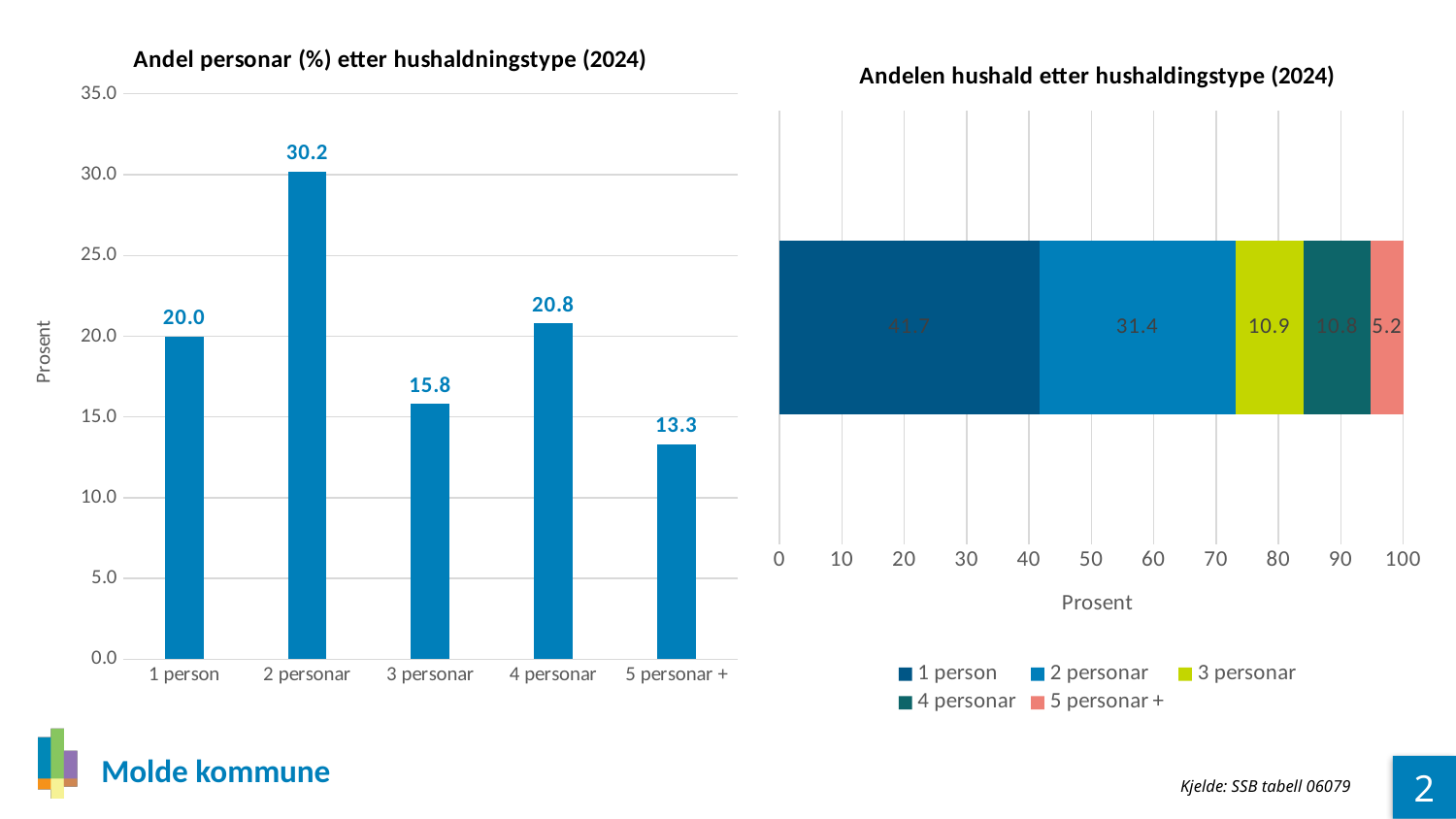
In the chart 'Andel personar (%) etter hushaldningstype (2024)', what is the value for 5 personar +? 13.3 In the chart 'Andel personar (%) etter hushaldningstype (2024)', how many categories are shown on the x axis? 5 In the chart 'Andel personar (%) etter hushaldningstype (2024)', what is the value for 2 personar? 30.2 In the chart 'Andel personar (%) etter hushaldningstype (2024)', which category has the highest value? 2 personar What kind of chart is 'Andel personar (%) etter hushaldningstype (2024)'? Bar chart In the chart 'Andelen hushald etter hushaldingstype (2024)', how many series does the legend list? 5 In the chart 'Andelen hushald etter hushaldingstype (2024)', what is the total of the stacked bar? 100.0 In the chart 'Andel personar (%) etter hushaldningstype (2024)', what is the difference between the values for 2 personar and 3 personar? 14.4 In the chart 'Andelen hushald etter hushaldingstype (2024)', what is the value for 1 person? 41.7 In the chart 'Andelen hushald etter hushaldingstype (2024)', which is larger, the value for 1 person or the value for 2 personar? 1 person In the chart 'Andel personar (%) etter hushaldningstype (2024)', which category has the lowest value? 5 personar + In the chart 'Andelen hushald etter hushaldingstype (2024)', what is the value for 5 personar +? 5.2